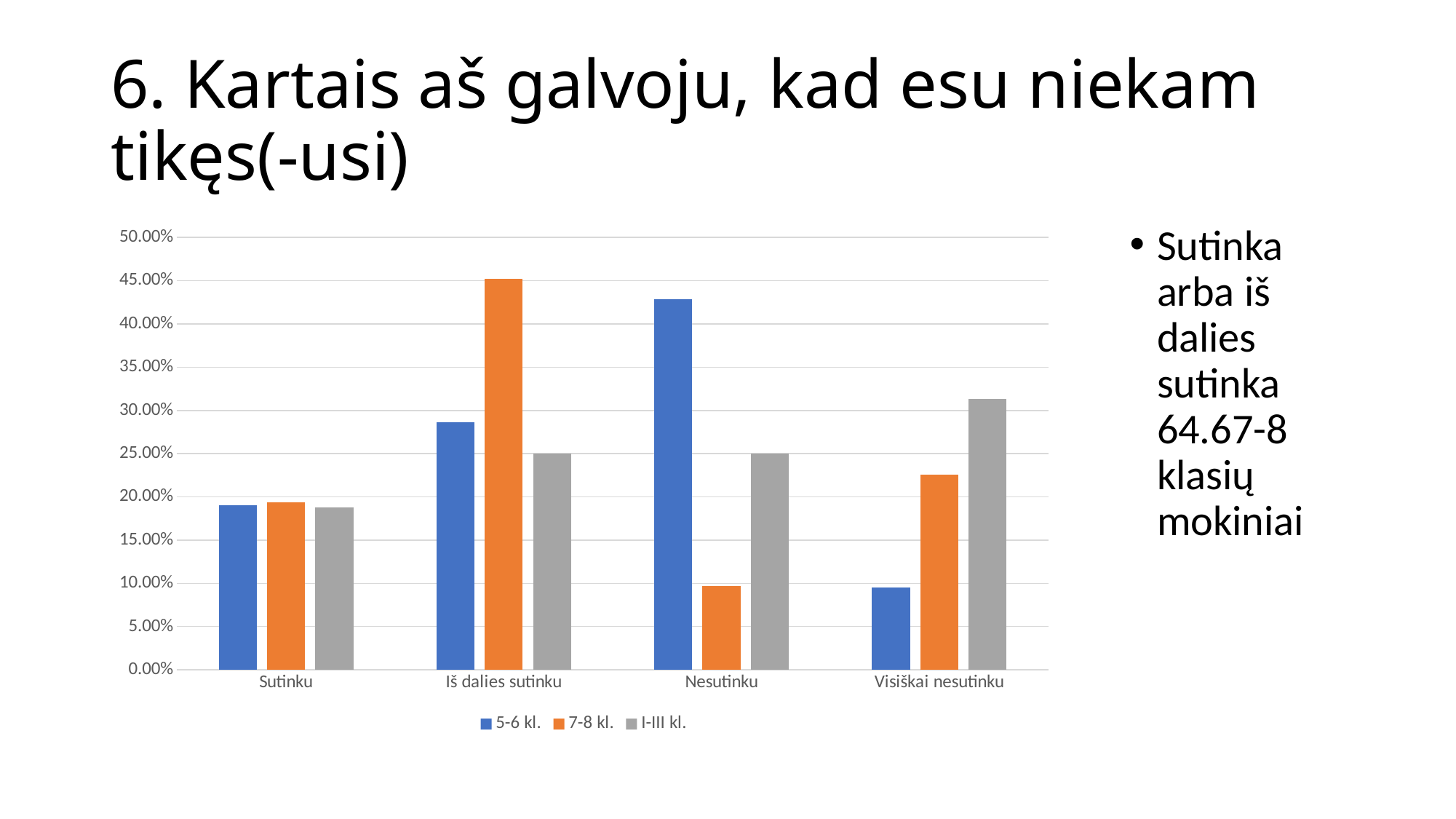
Which series has the highest value for the category 'Visiškai nesutinku'? I-III kl. Is the value for 5-6 kl. in the category 'Nesutinku' greater or less than 40.00%? greater How many series does the chart legend list? 3 What are the three series listed in the chart legend? 5-6 kl., 7-8 kl., I-III kl. For 'Visiškai nesutinku', which is larger: the value for 7-8 kl. or the value for I-III kl.? I-III kl. Which series has the lowest value for the category 'Nesutinku'? 7-8 kl. Which series has the highest value for the category 'Nesutinku'? 5-6 kl. Which series has the highest value for the category 'Iš dalies sutinku'? 7-8 kl. Is the value for 7-8 kl. in the category 'Iš dalies sutinku' greater or less than 40.00%? greater How many categories are shown on the x axis of the chart? 4 What kind of chart is shown on the slide? bar chart